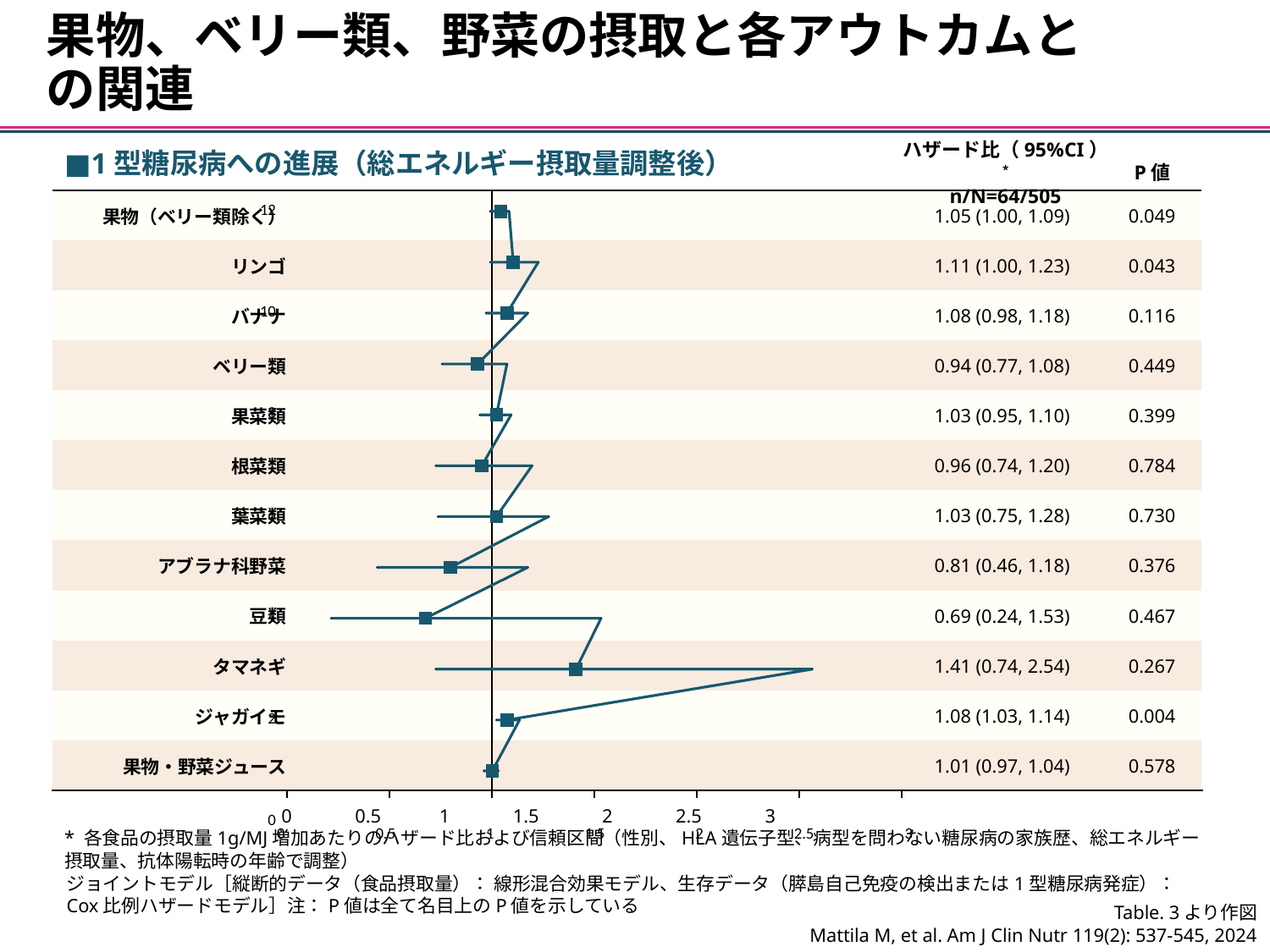
Which food category has the highest hazard ratio? タマネギ Which food category has the smallest P value? ジャガイモ What is the n/N value shown in the hazard ratio column header? n/N=64/505 How many food categories are plotted in the chart? 12 What kind of chart is shown on the slide? Forest plot What is the hazard ratio (95% CI) for タマネギ? 1.41 (0.74, 2.54) Which has the larger hazard ratio, リンゴ or ベリー類? リンゴ Is the hazard ratio for アブラナ科野菜 greater or less than 1? less What is the P value for ジャガイモ? 0.004 What is the difference between the hazard ratio for タマネギ and the hazard ratio for 豆類? 0.72 Which food category has the lowest hazard ratio? 豆類 What is the hazard ratio (95% CI) for 豆類? 0.69 (0.24, 1.53)